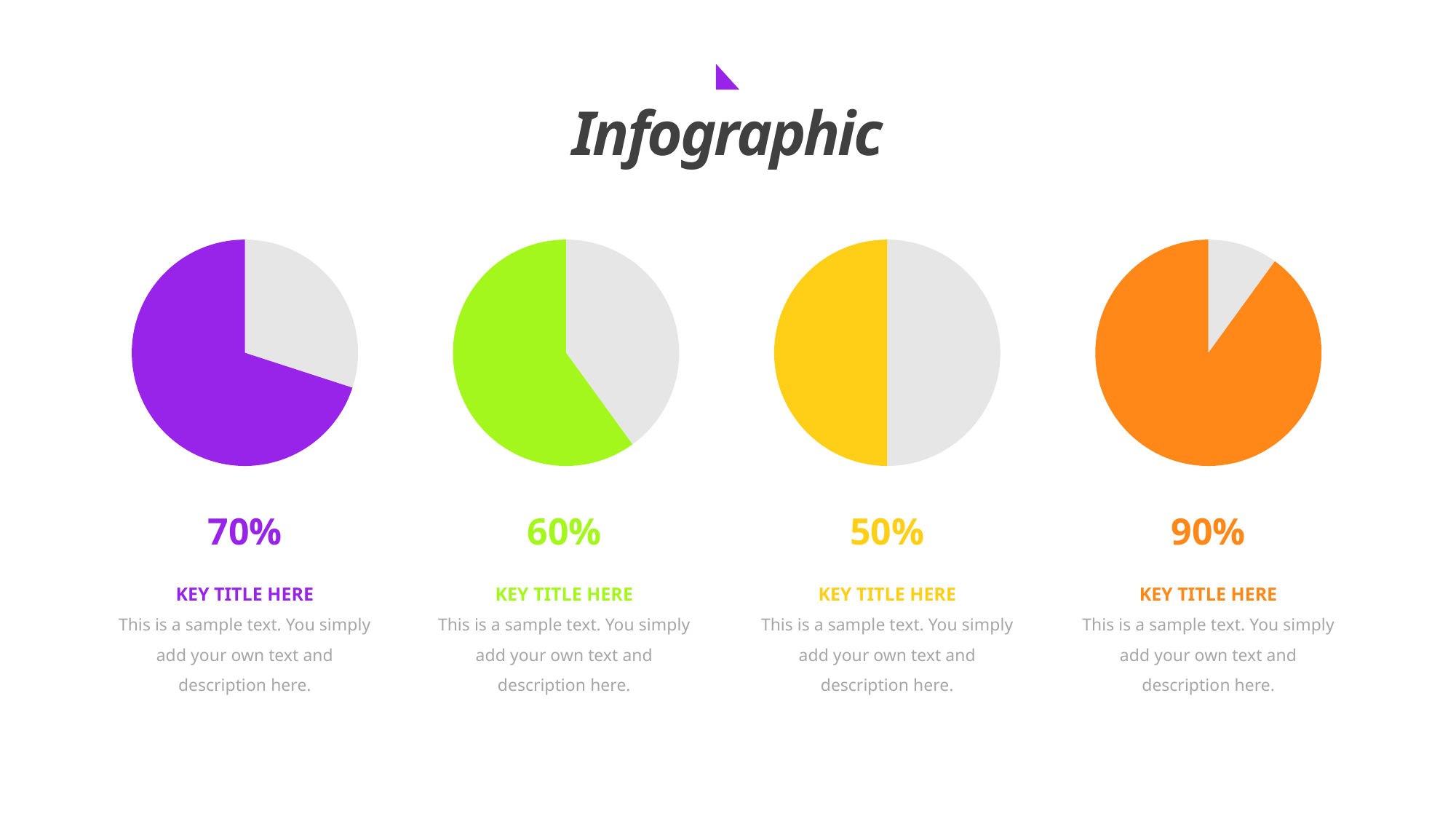
What is the title at the top of the slide? Infographic What percentage is shown below the rightmost (orange) pie chart? 90% Which is larger, the percentage of the purple pie chart or the percentage of the green pie chart? The purple pie chart (70%) What share of the yellow pie chart is filled by the coloured slice? 50% What percentage is shown below the third (yellow) pie chart from the left? 50% What percentage is shown below the second (green) pie chart from the left? 60% Which pie chart shows the lowest percentage? The third (yellow) pie chart, 50% What kind of charts are shown on the slide? Pie charts What is the difference between the percentage of the orange pie chart and the percentage of the purple pie chart? 20% Which pie chart shows the highest percentage? The rightmost (orange) pie chart, 90% How many pie charts are on the slide? 4 What percentage is shown below the leftmost (purple) pie chart? 70%